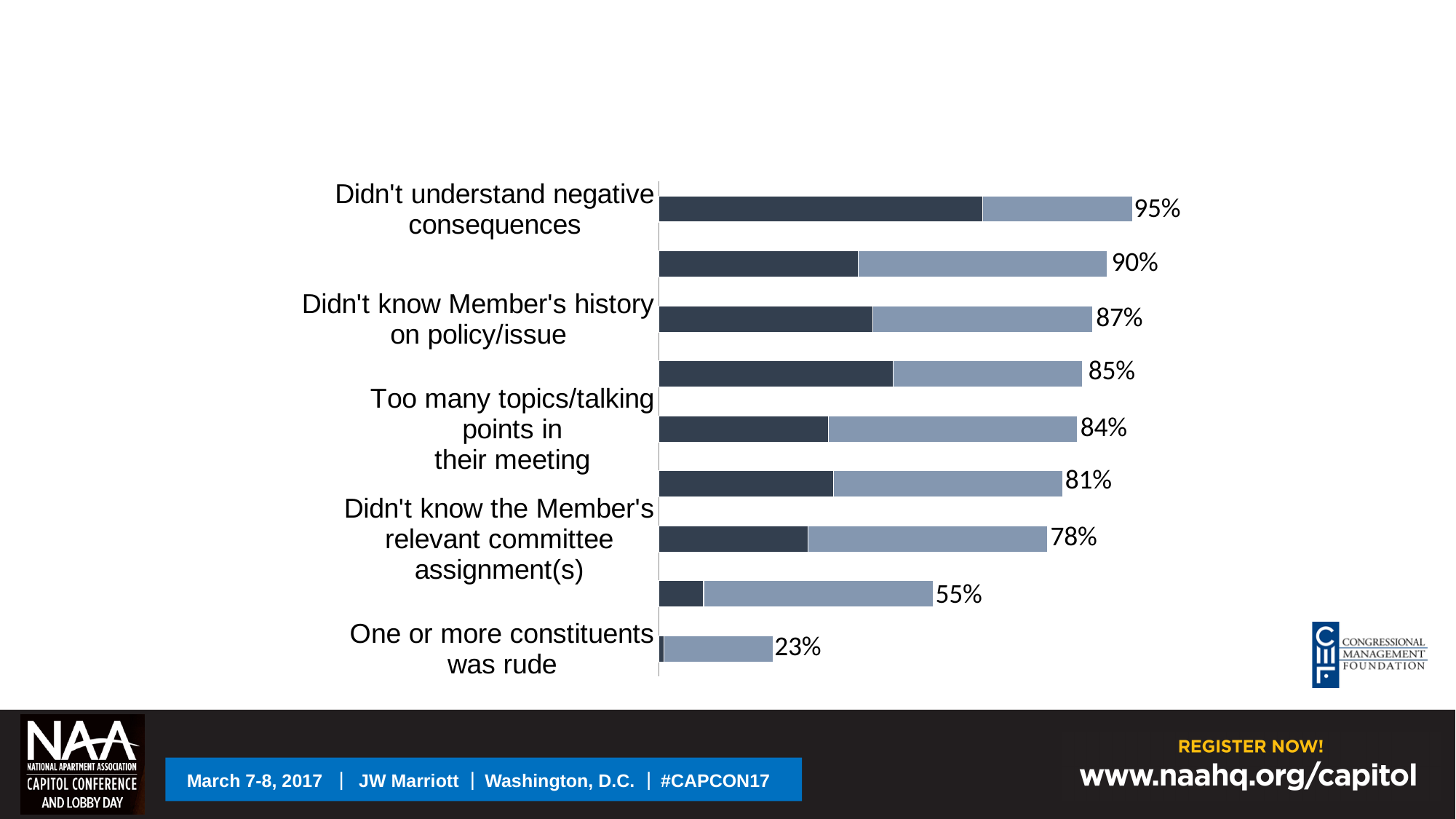
What is the value shown for "Too many topics/talking points in their meeting"? 84% What kind of chart is shown on the slide? Stacked horizontal bar chart Which category has the lowest value? One or more constituents was rude How many bars are plotted in the chart? 9 What is the value shown for "Didn't know the Member's relevant committee assignment(s)"? 78% What is the difference between the values for "Didn't know Member's history on policy/issue" and "Didn't know the Member's relevant committee assignment(s)"? 9 percentage points Which category has the highest value? Didn't understand negative consequences Which is larger: the value for "Too many topics/talking points in their meeting" or the value for "Didn't know the Member's relevant committee assignment(s)"? Too many topics/talking points in their meeting What is the value shown for "Didn't know Member's history on policy/issue"? 87% What is the difference between the values for "Didn't understand negative consequences" and "One or more constituents was rude"? 72 percentage points What is the value shown for "One or more constituents was rude"? 23% What is the value shown for "Didn't understand negative consequences"? 95%